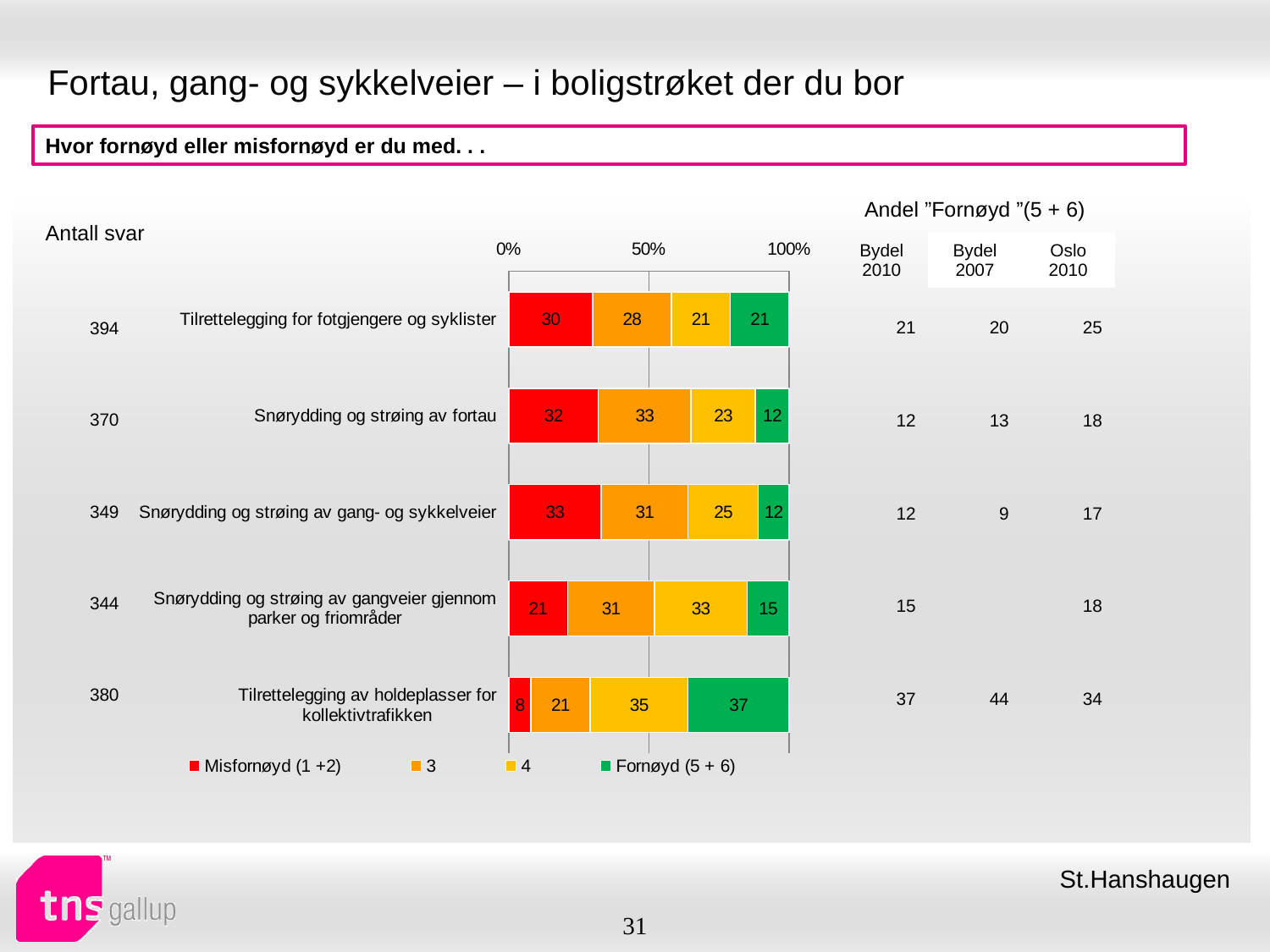
How many categories are plotted in the chart? 5 Which is larger: the Fornøyd (5 + 6) value for Tilrettelegging for fotgjengere og syklister or for Snørydding og strøing av fortau? Tilrettelegging for fotgjengere og syklister What is the Misfornøyd (1 +2) value for Snørydding og strøing av fortau? 32 What is the Fornøyd (5 + 6) value for Tilrettelegging av holdeplasser for kollektivtrafikken? 37 What is the difference between the Misfornøyd (1 +2) values for Snørydding og strøing av gang- og sykkelveier and Tilrettelegging av holdeplasser for kollektivtrafikken? 25 What kind of chart is shown on the slide? stacked bar chart What colour represents the Fornøyd (5 + 6) series in the chart? green Which category has the highest Fornøyd (5 + 6) value? Tilrettelegging av holdeplasser for kollektivtrafikken What is the value of series 4 for Snørydding og strøing av gangveier gjennom parker og friområder? 33 What is the total of the stacked bar for Tilrettelegging for fotgjengere og syklister? 100 How many series does the legend list? 4 Which category has the lowest Misfornøyd (1 +2) value? Tilrettelegging av holdeplasser for kollektivtrafikken